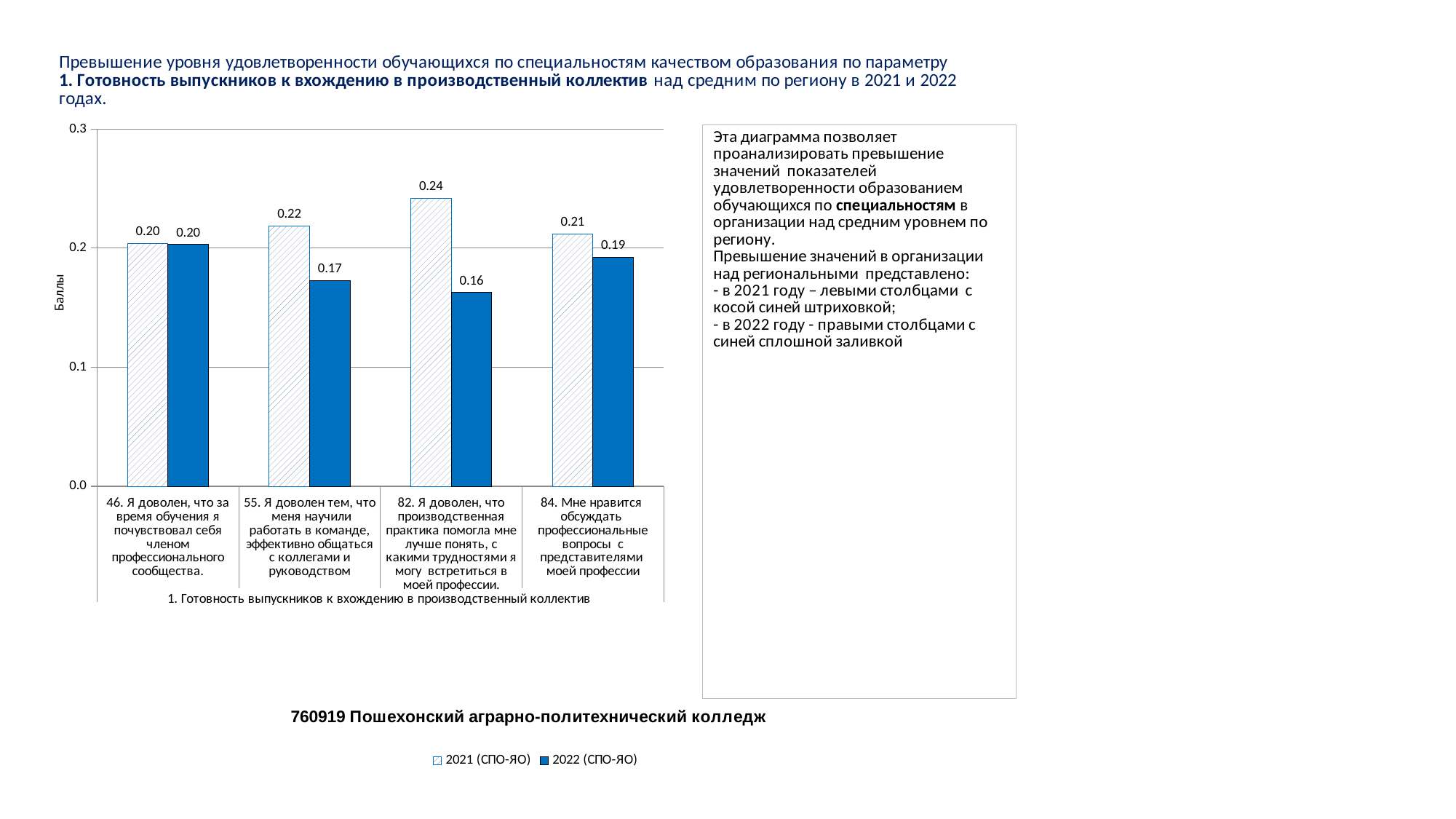
What is the 2021 (СПО-ЯО) value for category 82 ("Я доволен, что производственная практика помогла мне лучше понять...")? 0.24 What is the 2022 (СПО-ЯО) value for category 84 ("Мне нравится обсуждать профессиональные вопросы...")? 0.19 What is the label of the vertical axis of the chart? Баллы How many categories are shown on the x axis of the chart? 4 What is the 2022 (СПО-ЯО) value for category 55 ("Я доволен тем, что меня научили работать в команде...")? 0.17 What is the difference between the 2021 and 2022 values for category 55? 0.05 How many series does the legend list? 2 For category 84, which series has the larger value, 2021 (СПО-ЯО) or 2022 (СПО-ЯО)? 2021 (СПО-ЯО) Which category has the lowest 2022 (СПО-ЯО) value? 82. Я доволен, что производственная практика помогла мне лучше понять, с какими трудностями я могу встретиться в моей профессии. What is the difference between the 2021 and 2022 values for category 82? 0.08 What type of chart is shown on the slide? Bar chart Which category has the highest 2021 (СПО-ЯО) value? 82. Я доволен, что производственная практика помогла мне лучше понять, с какими трудностями я могу встретиться в моей профессии.